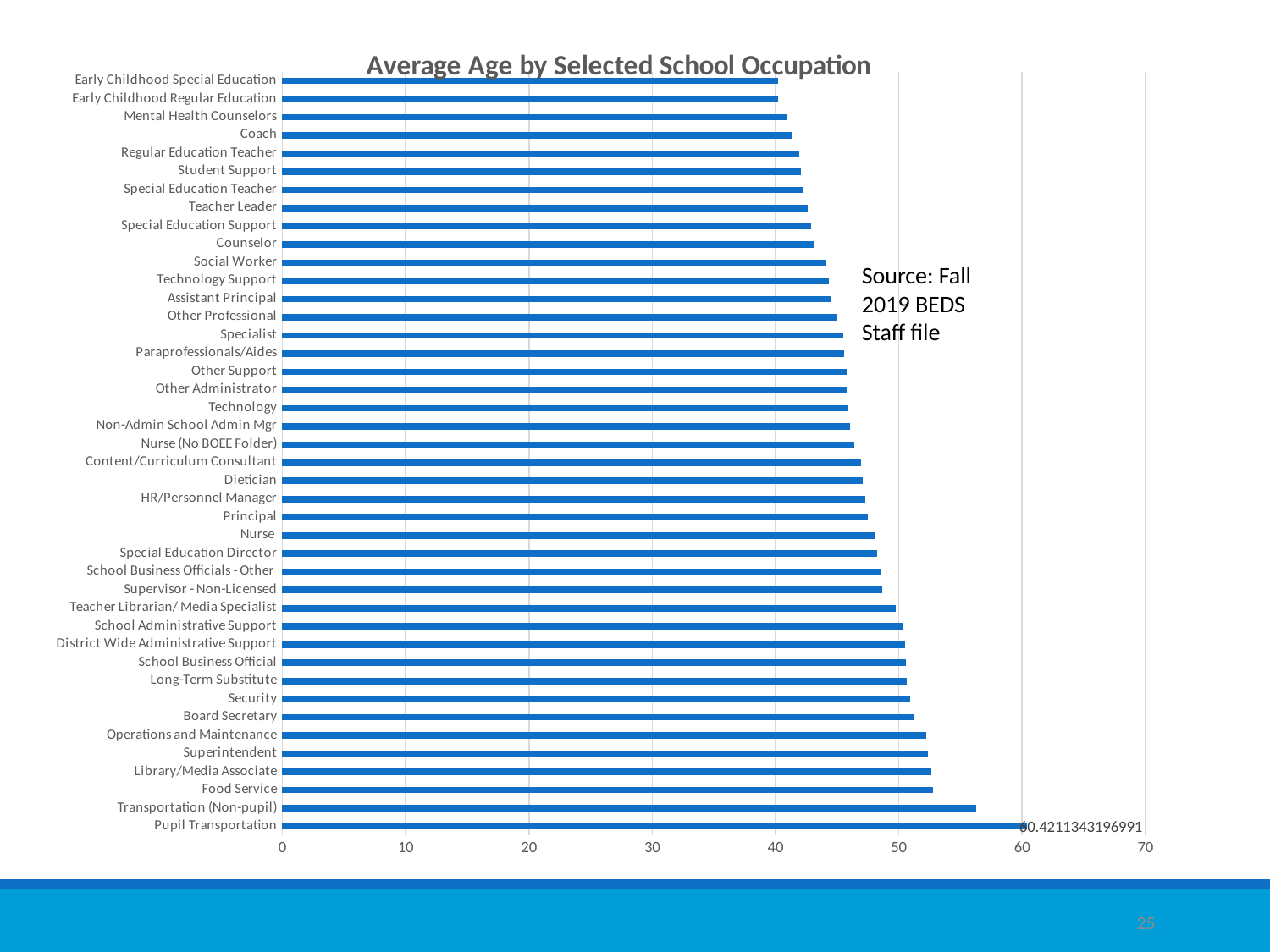
Which has a higher average age, Pupil Transportation or Coach? Pupil Transportation What source is cited for the chart data? Fall 2019 BEDS Staff file Which occupation has the highest average age? Pupil Transportation What is the value shown for Pupil Transportation? 60.4211343196991 How many occupations are plotted in the chart? 42 Which has a higher average age, Superintendent or Principal? Superintendent What is the title of the chart? Average Age by Selected School Occupation What type of chart is shown on the slide? bar chart Is the value for Early Childhood Special Education greater or less than 50? less Is the value for Food Service greater or less than 50? greater Is the value for Coach greater or less than 50? less